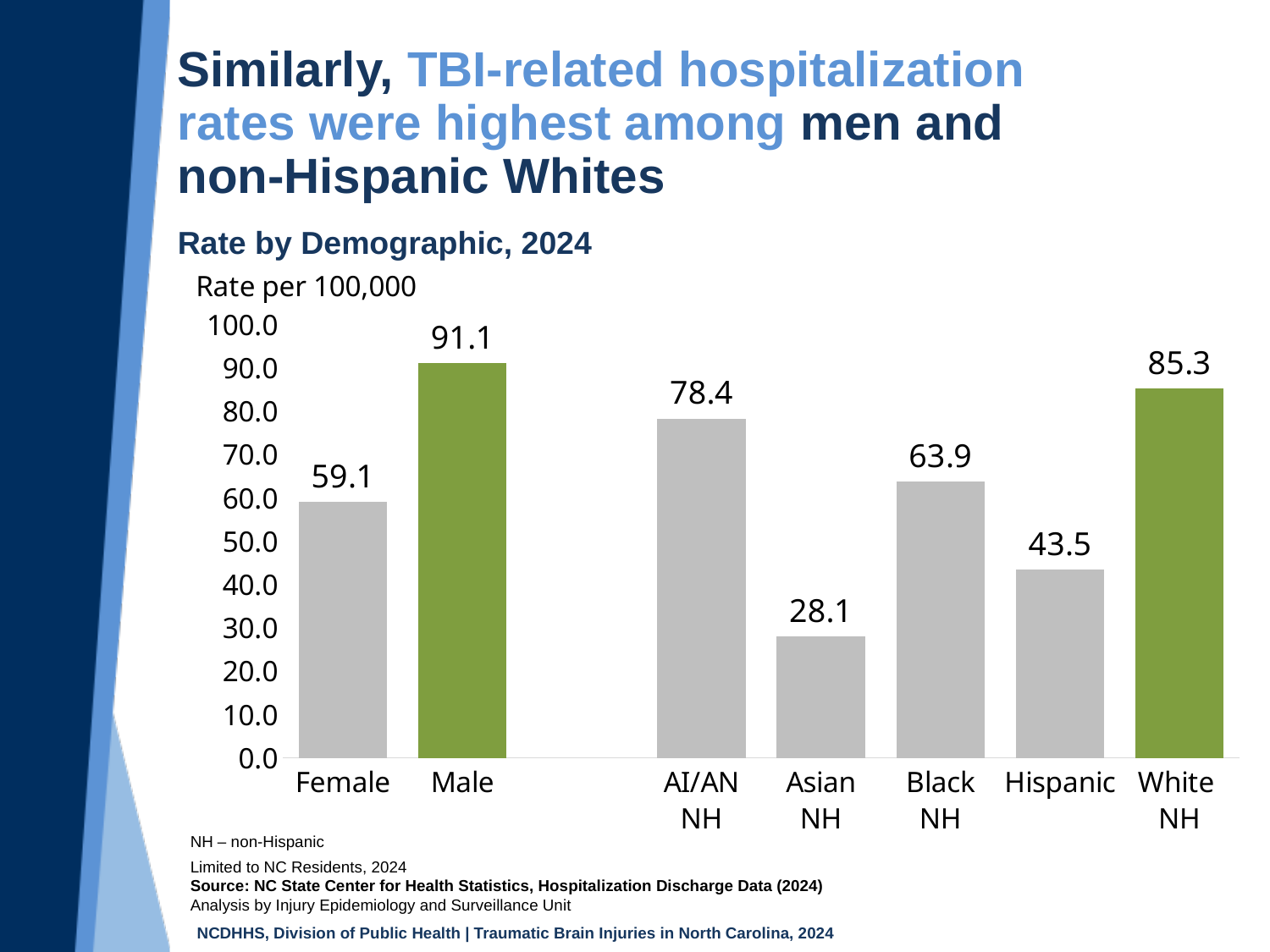
What is the rate per 100,000 for Asian NH? 28.1 What is the title of the chart? Rate by Demographic, 2024 Which category has the lowest rate on the chart? Asian NH Which category has the highest rate on the chart? Male Is the value for Hispanic greater or less than 50.0? less How many categories are shown on the chart? 7 What is the rate per 100,000 for Hispanic? 43.5 What is the difference between the Male and Female rates? 32.0 What kind of chart is shown on the slide? Bar chart What is the difference between the White NH and Black NH rates? 21.4 Which has a higher rate, AI/AN NH or Black NH? AI/AN NH What is the TBI-related hospitalization rate per 100,000 for Male? 91.1